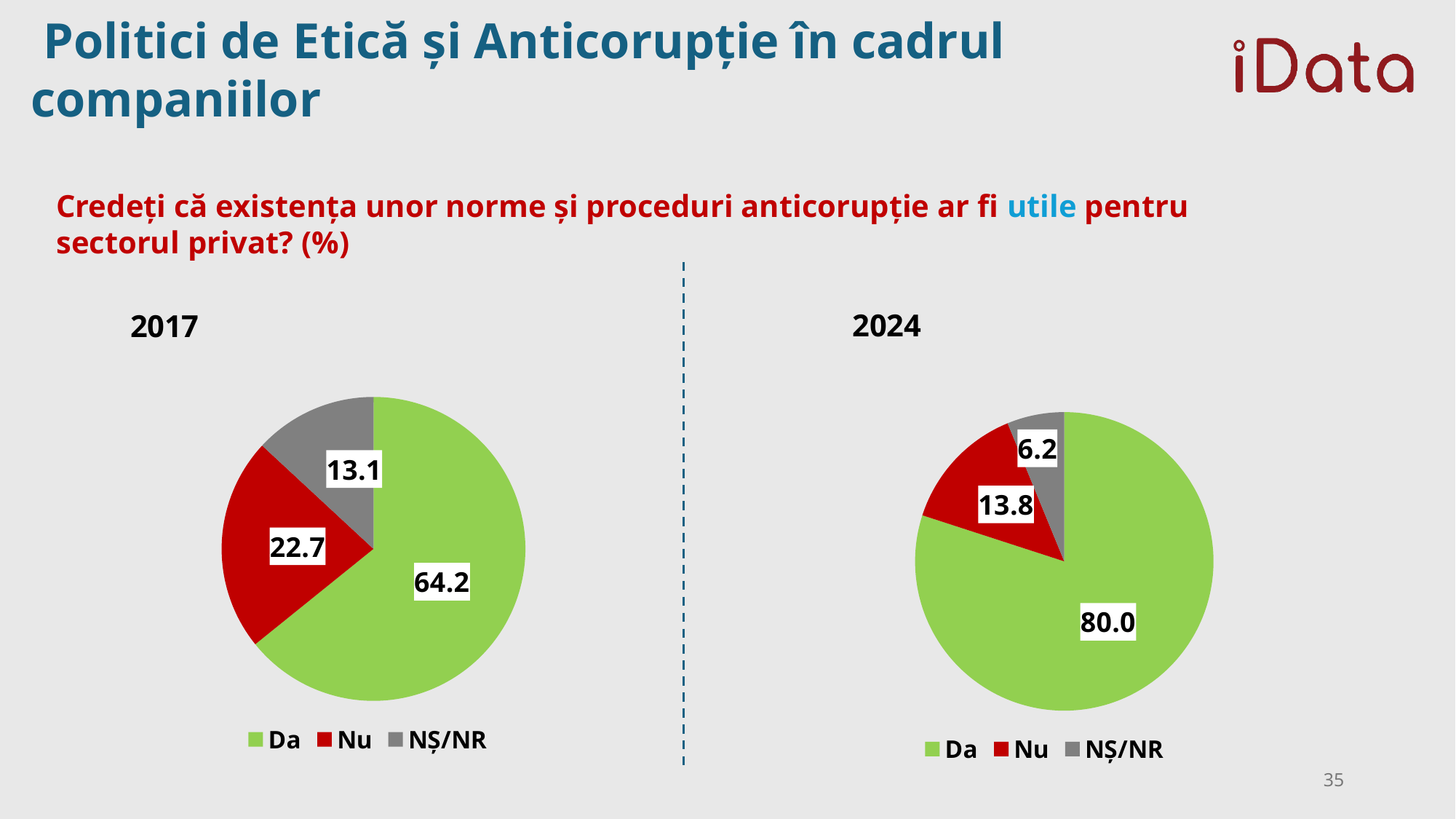
In the 2017 pie chart, what is the value for Da? 64.2 How many slices does the 2024 pie chart have? 3 In the 2017 pie chart, what colour is the Nu slice? Red In the 2017 pie chart, what is the value for Nu? 22.7 In the 2024 pie chart, what is the value for NȘ/NR? 6.2 Which is larger: the Nu value in the 2017 pie chart or the Nu value in the 2024 pie chart? 2017 What is the difference between the Da value in the 2024 pie chart and the Da value in the 2017 pie chart? 15.8 In the 2024 pie chart, what is the value for Nu? 13.8 In the 2017 pie chart, which category has the largest slice? Da In the 2017 pie chart, what is the difference between the Nu and NȘ/NR values? 9.6 What type of chart is used for the 2017 data? Pie chart In the 2024 pie chart, which category has the smallest slice? NȘ/NR